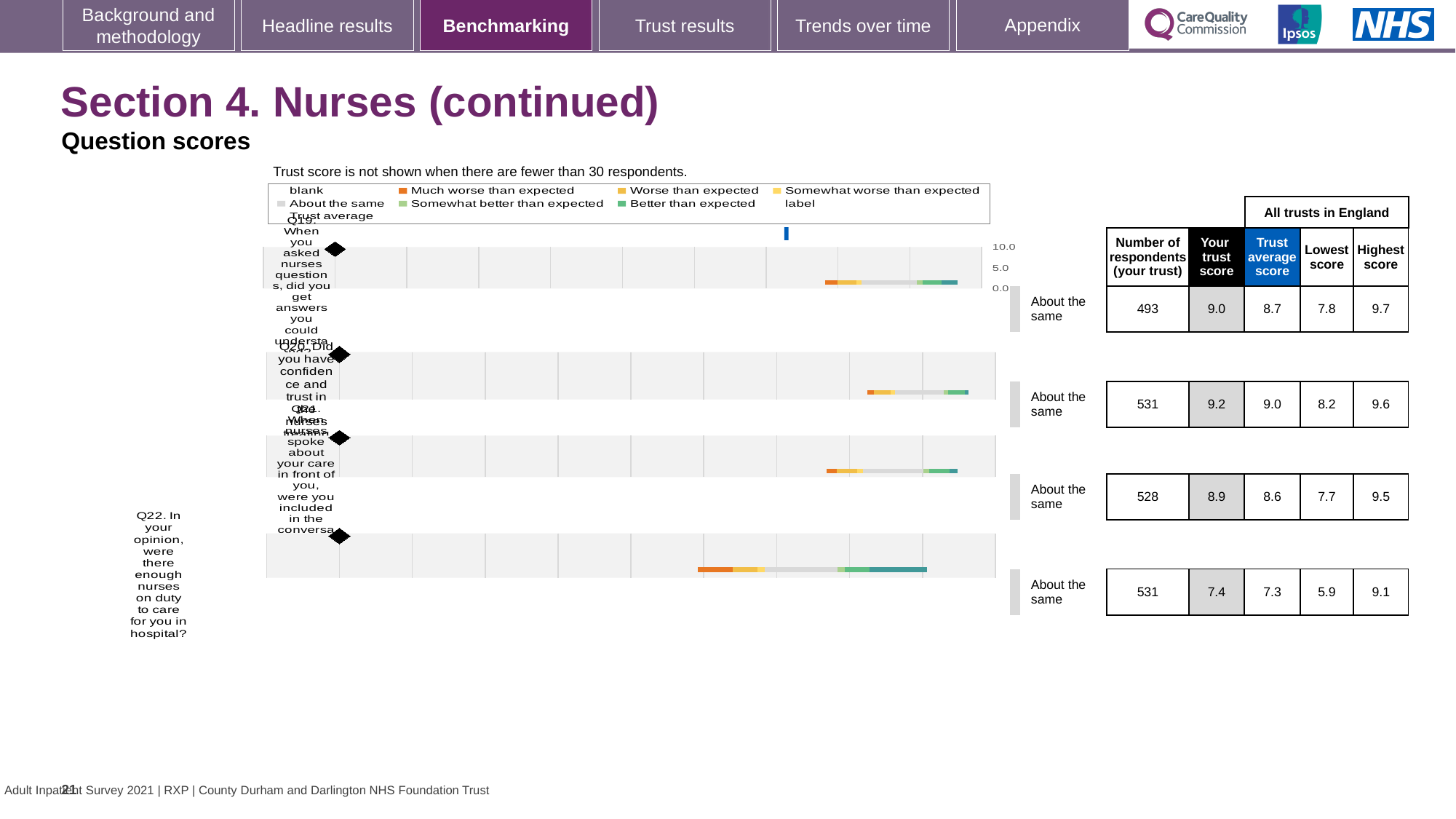
Which has the larger trust score, Q19 or Q20? Q20 Which question has the lowest trust score? Q22 What is the trust score for Q19 (When you asked nurses questions, did you get answers you could understand)? 9.0 What is the difference between the trust score and the trust average score for Q22? 0.1 What benchmark category label is shown for all four questions? About the same What is the lowest score across all trusts in England for Q22 (were there enough nurses on duty)? 5.9 Is the trust score for Q22 greater or less than 5.0? greater What is the highest score across all trusts in England for Q21? 9.5 How many questions (categories) are plotted in the chart? 4 What kind of chart is shown on the slide? bar chart How many respondents does the trust have for Q20 (Did you have confidence and trust in the nurses)? 531 Which question has the highest trust score? Q20